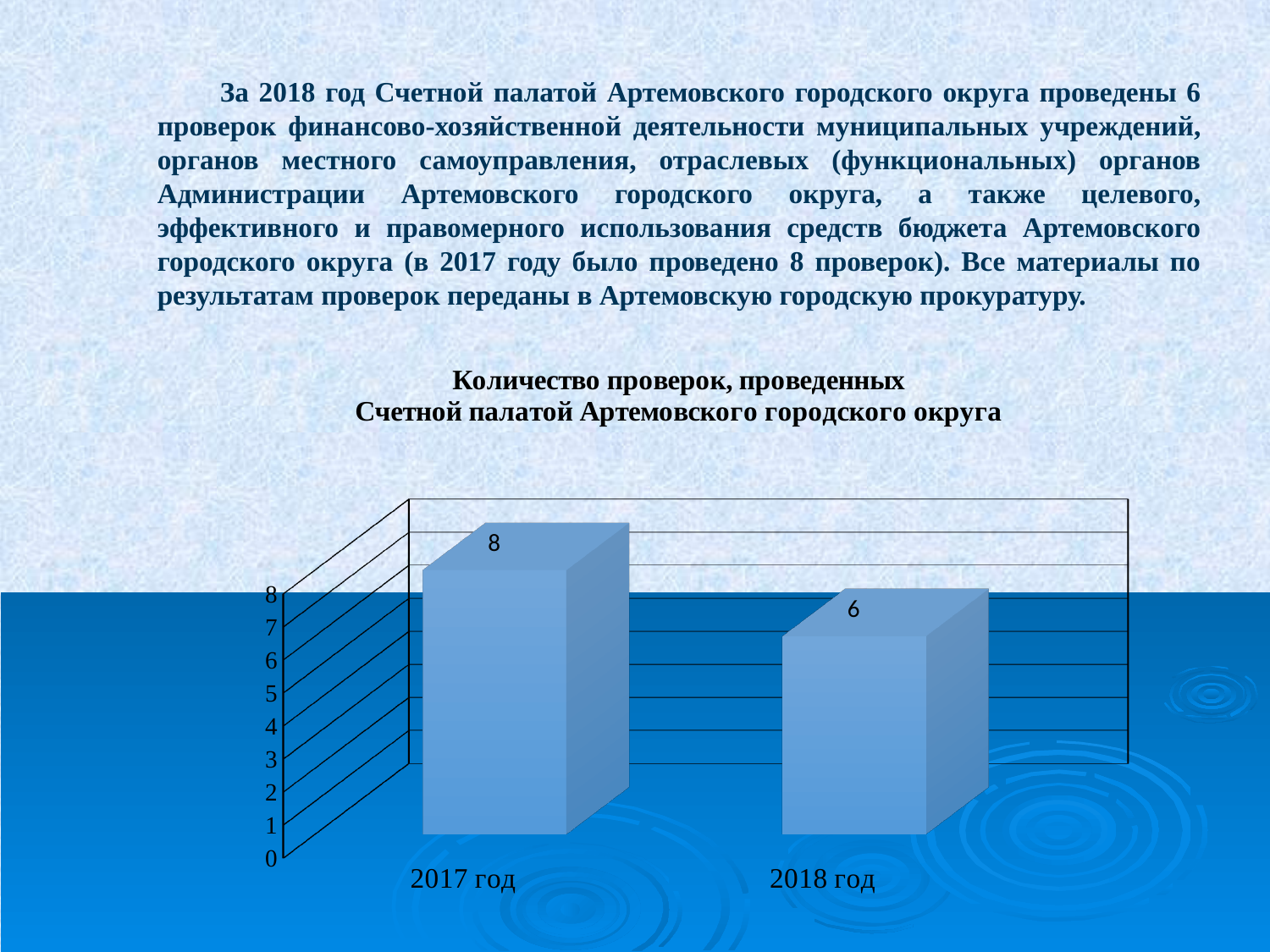
Do the values rise or fall from 2017 год to 2018 год? fall What is the value for 2018 год? 6 Which is larger, the value for 2017 год or the value for 2018 год? 2017 год Is the value for 2018 год greater or less than 7? less How many categories are shown on the x axis? 2 What kind of chart is shown on the slide? bar chart What is the maximum value shown on the vertical axis? 8 Which year has the lowest number of inspections? 2018 год What is the value for 2017 год? 8 What is the title of the chart? Количество проверок, проведенных Счетной палатой Артемовского городского округа What is the difference between the values for 2017 год and 2018 год? 2 Which year has the highest number of inspections? 2017 год